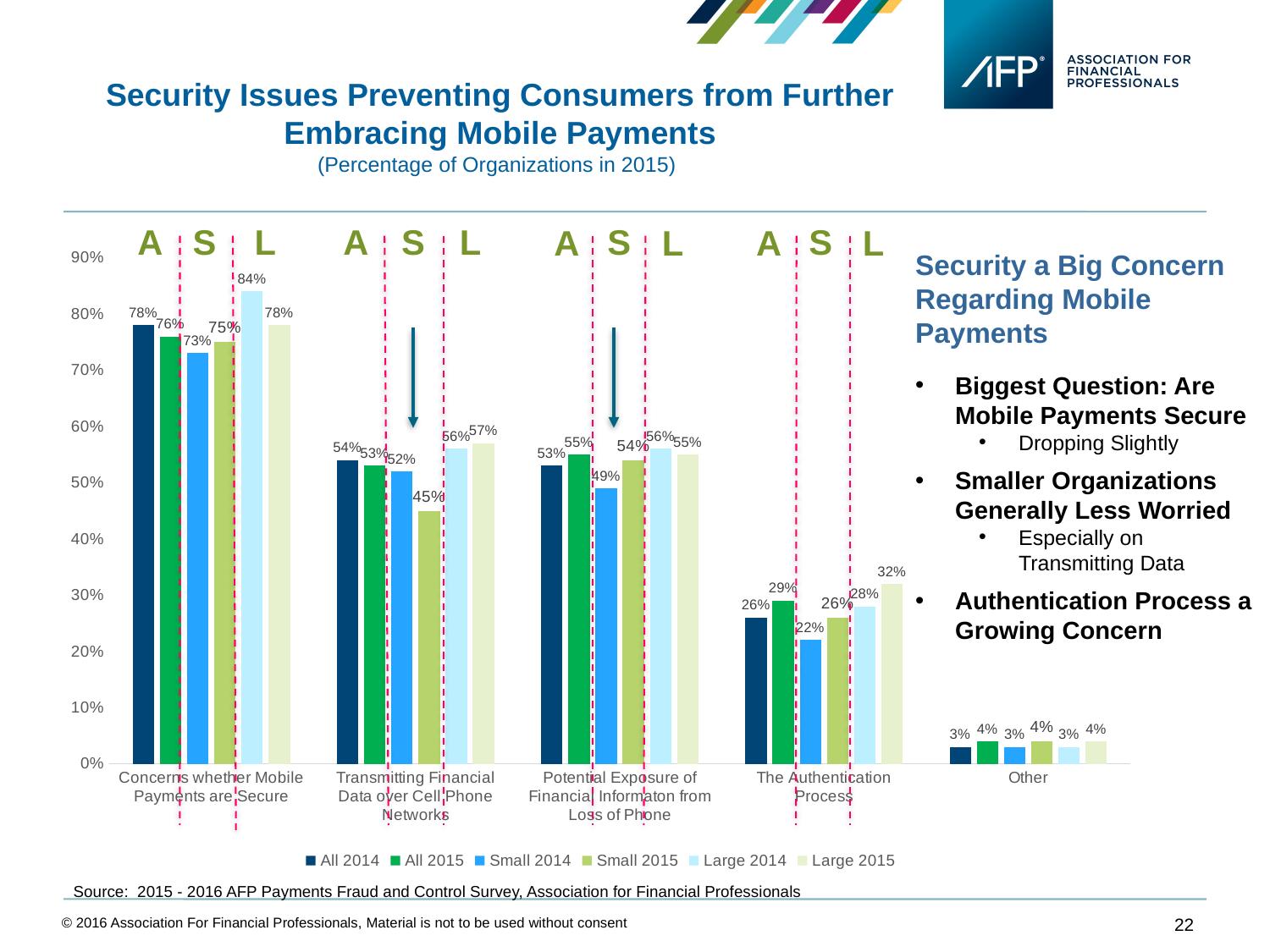
Which category has the highest value for the All 2015 series? Concerns whether Mobile Payments are Secure What is the value for Small 2014 in the 'Potential Exposure of Financial Information from Loss of Phone' category? 49% What is the difference between the All 2014 and All 2015 values in 'The Authentication Process' category? 3% What is the value for Large 2015 in 'The Authentication Process' category? 32% What is the difference between the Large 2014 and Small 2014 values in the 'Concerns whether Mobile Payments are Secure' category? 11% How many series does the legend list? 6 What is the value for Small 2015 in the 'Transmitting Financial Data over Cell Phone Networks' category? 45% What is the value for Large 2014 in the 'Concerns whether Mobile Payments are Secure' category? 84% Which category has the lowest value for the Large 2014 series? Other What kind of chart is shown on the slide? Bar chart In 'The Authentication Process' category, which is larger: the All 2015 value or the Small 2014 value? All 2015 How many categories are shown on the x axis? 5